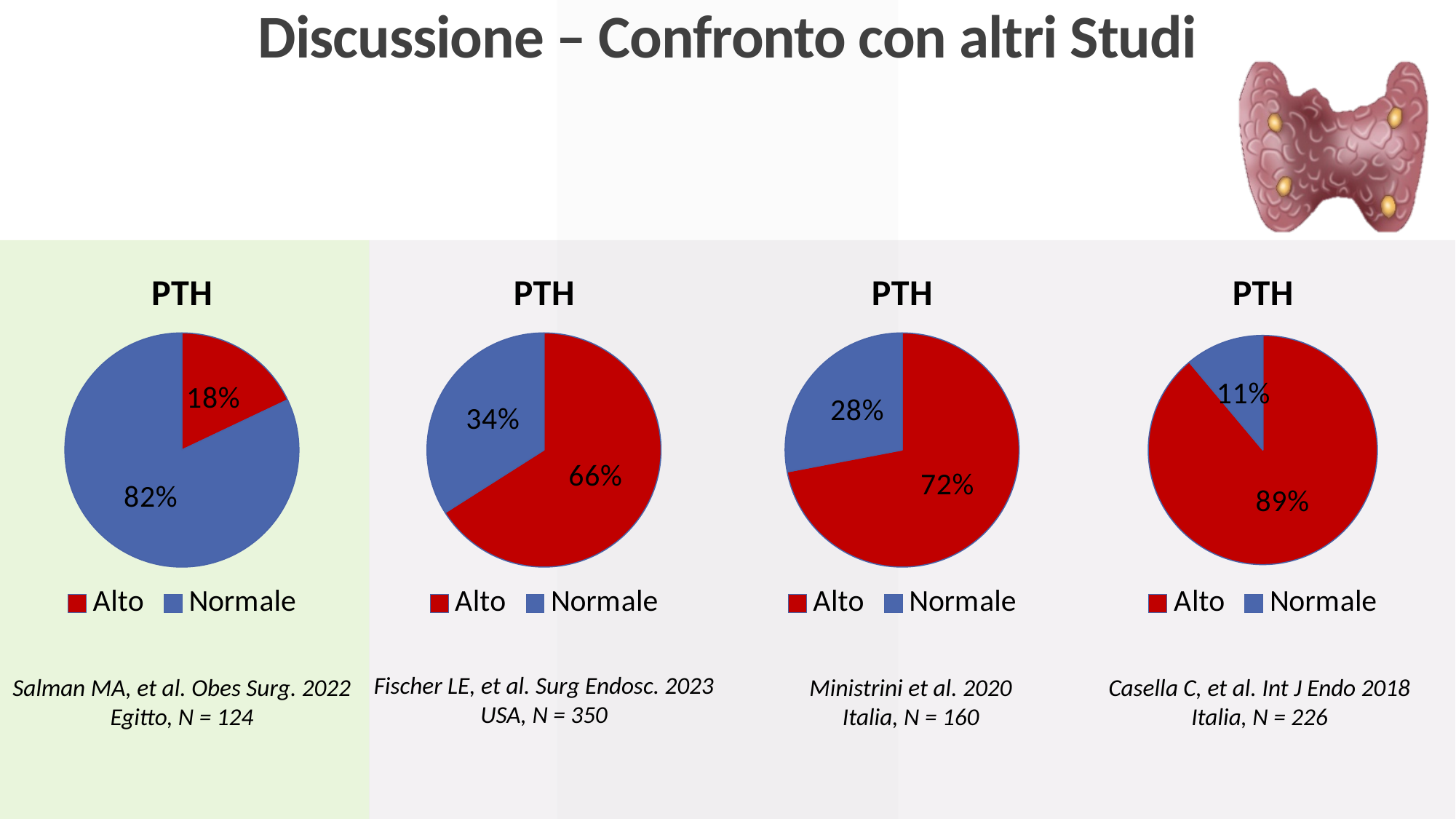
In the rightmost PTH pie chart (Casella C, et al., Italia), which slice is larger, Alto or Normale? Alto In the second PTH pie chart from the left (Fischer LE, et al., USA), what percentage is labelled for the Alto slice? 66% In the leftmost PTH pie chart (Salman MA, et al., Egitto), what percentage is labelled for the Normale slice? 82% How many entries does the legend of the rightmost PTH pie chart (Casella C, et al., Italia) list? 2 In the rightmost PTH pie chart (Casella C, et al., Italia), what percentage is labelled for the Normale slice? 11% In the third PTH pie chart from the left (Ministrini et al., Italia), what percentage is labelled for the Alto slice? 72% In the leftmost PTH pie chart (Salman MA, et al., Egitto), which slice is the largest? Normale In the second PTH pie chart from the left (Fischer LE, et al., USA), what percentage is labelled for the Normale slice? 34% How many slices does the second PTH pie chart from the left (Fischer LE, et al., USA) have? 2 In the third PTH pie chart from the left (Ministrini et al., Italia), what is the difference between the Alto and Normale percentages? 44% What kind of chart is used for each of the four PTH charts on the slide? Pie chart In the leftmost PTH pie chart (Salman MA, et al., Egitto), what percentage is labelled for the Alto slice? 18%